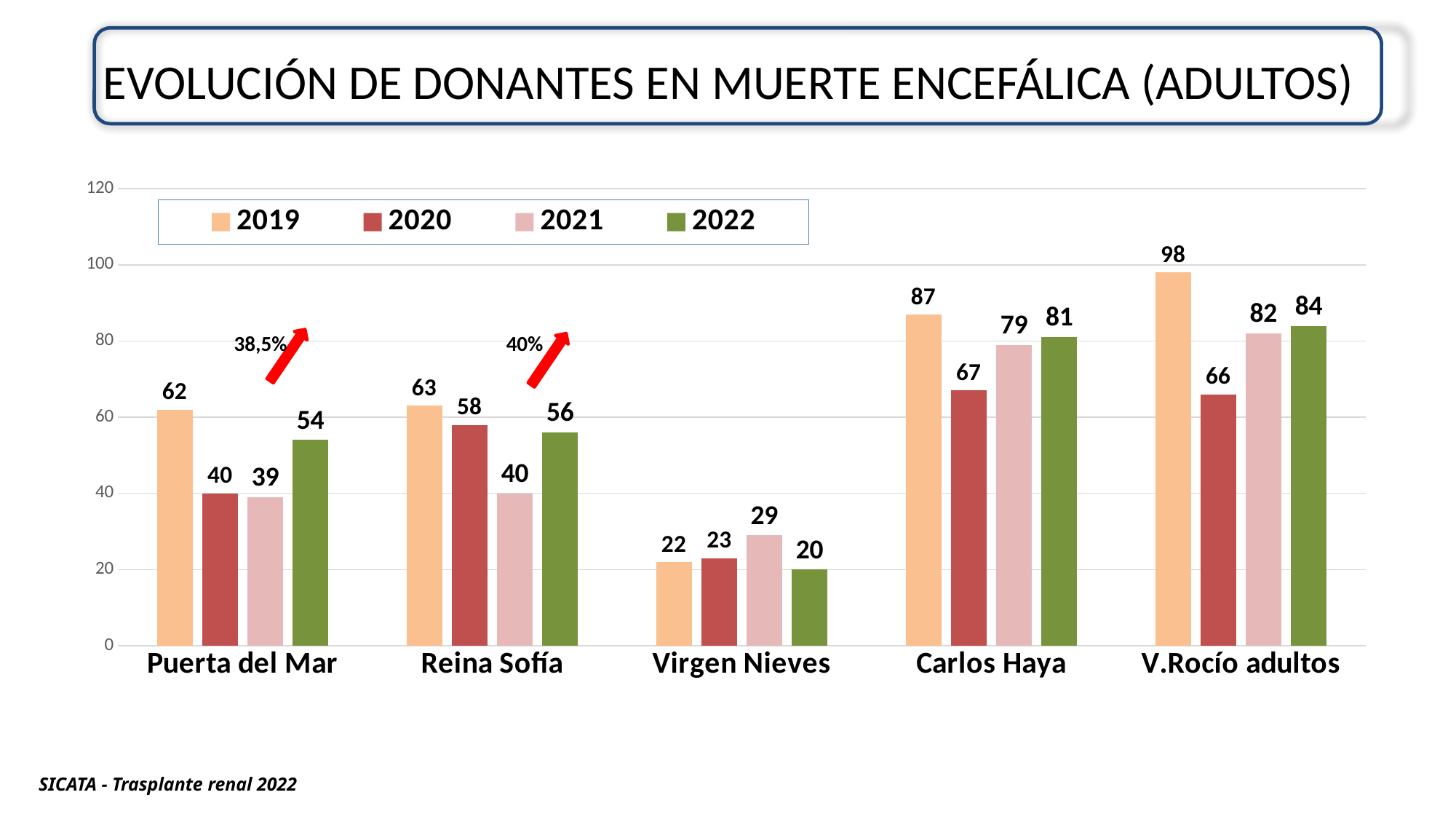
What is the difference between the 2022 and 2021 values for Puerta del Mar? 15 Which hospital has the lowest value in 2020? Virgen Nieves Which is larger for Reina Sofía: the 2020 value or the 2022 value? 2020 What is the value for Virgen Nieves in 2022? 20 What is the difference between the 2019 and 2020 values for V.Rocío adultos? 32 How many series does the legend list? 4 What percentage is written next to the red arrow above Reina Sofía? 40% What kind of chart is shown on the slide? Bar chart What is the value for Carlos Haya in 2021? 79 Which hospital has the highest value in 2022? V.Rocío adultos How many hospitals (categories) are shown on the x axis? 5 What is the value for V.Rocío adultos in 2019? 98